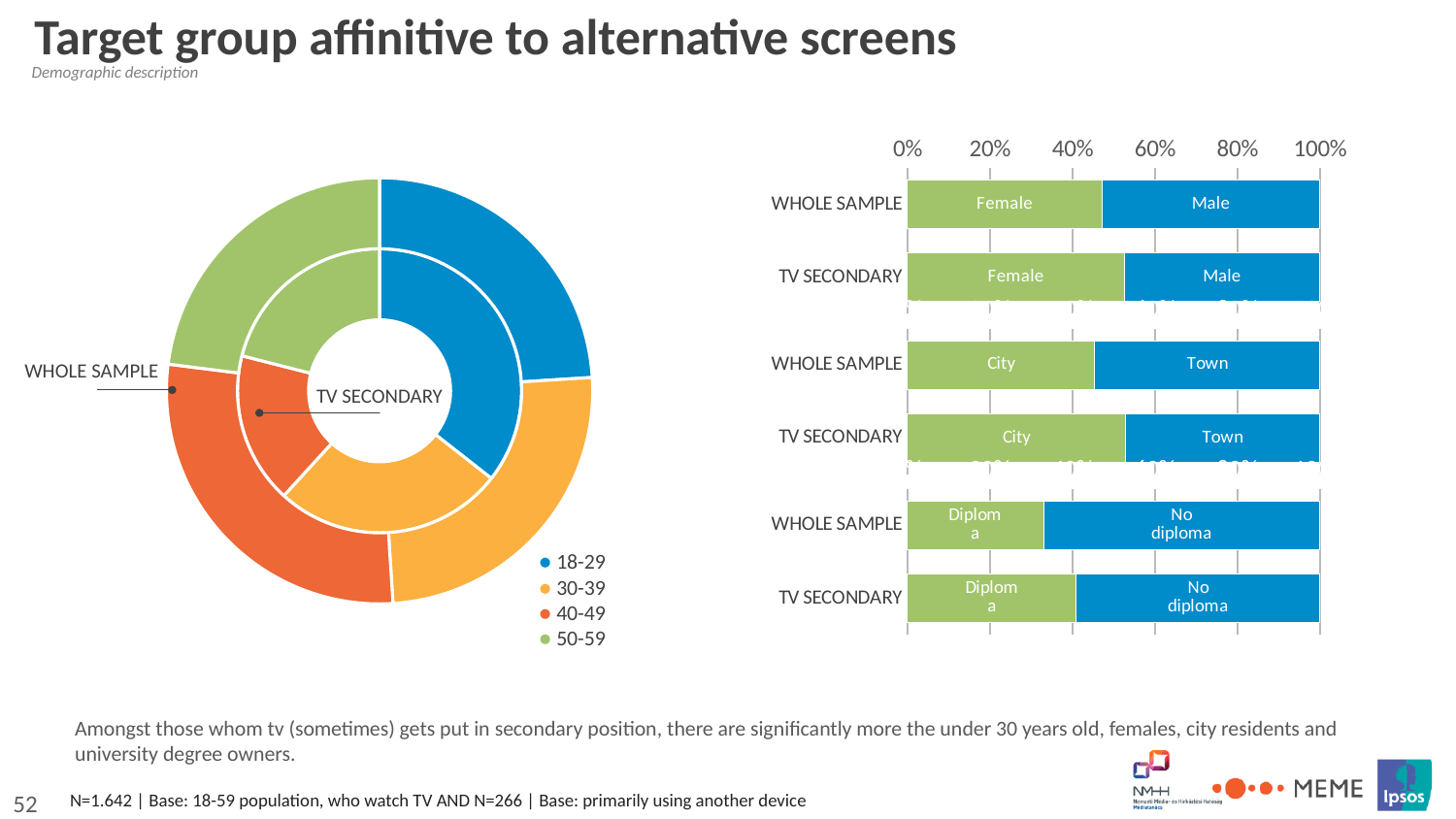
In the City/Town bar chart, which segment is larger for WHOLE SAMPLE, City or Town? Town In the City/Town bar chart, is the City share for TV SECONDARY greater or less than 40%? greater In the Diploma/No diploma bar chart, which segment is larger for TV SECONDARY, Diploma or No diploma? No diploma What kind of chart is used on the right side of the slide for Female/Male, City/Town and Diploma/No diploma? Stacked bar chart What kind of chart is on the left side of the slide? Doughnut chart In the Diploma/No diploma bar chart, is the Diploma share for WHOLE SAMPLE greater or less than 40%? less How many age groups does the legend of the doughnut chart list? 4 In the Female/Male bar chart, is the Male share for WHOLE SAMPLE greater or less than 40%? greater How many bars does the Female/Male bar chart contain? 2 In the doughnut chart, which ring represents WHOLE SAMPLE, the outer or the inner? Outer